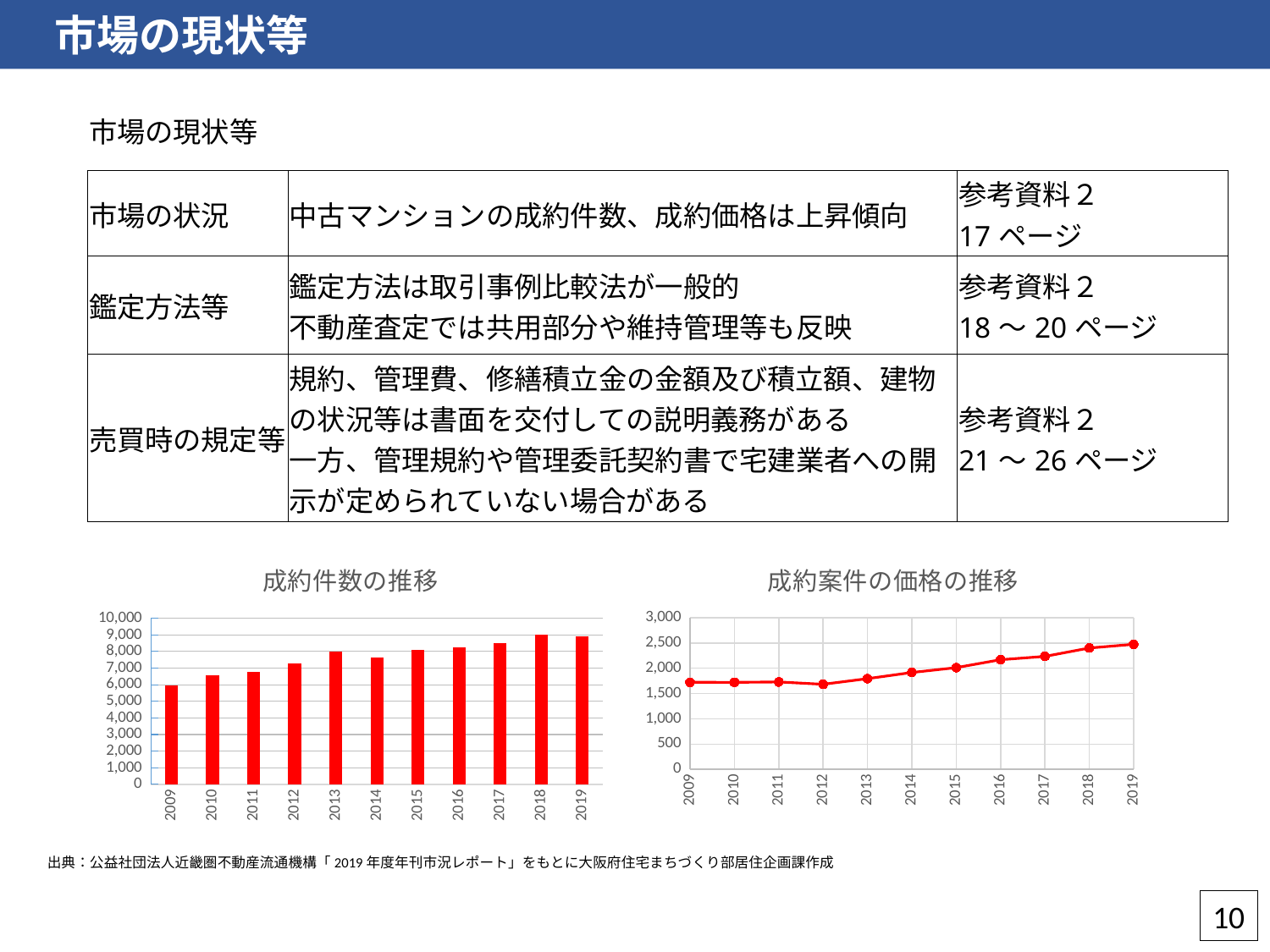
What kind of chart is the right chart titled 成約案件の価格の推移? line chart In the right chart 成約案件の価格の推移, which year has the highest value? 2019 In the left chart 成約件数の推移, how many years are shown on the x axis? 11 In the left chart 成約件数の推移, is the value for 2018 greater or less than 8,000? greater In the left chart 成約件数の推移, which year has the lowest bar? 2009 In the right chart 成約案件の価格の推移, is the value for 2012 greater or less than 2,000? less What kind of chart is the left chart titled 成約件数の推移? bar chart In the left chart 成約件数の推移, which is larger, the value for 2013 or the value for 2014? 2013 In the right chart 成約案件の価格の推移, is the value for 2019 greater or less than 2,000? greater In the right chart 成約案件の価格の推移, do the values generally rise or fall from 2012 to 2019? rise In the right chart 成約案件の価格の推移, how many data points are plotted? 11